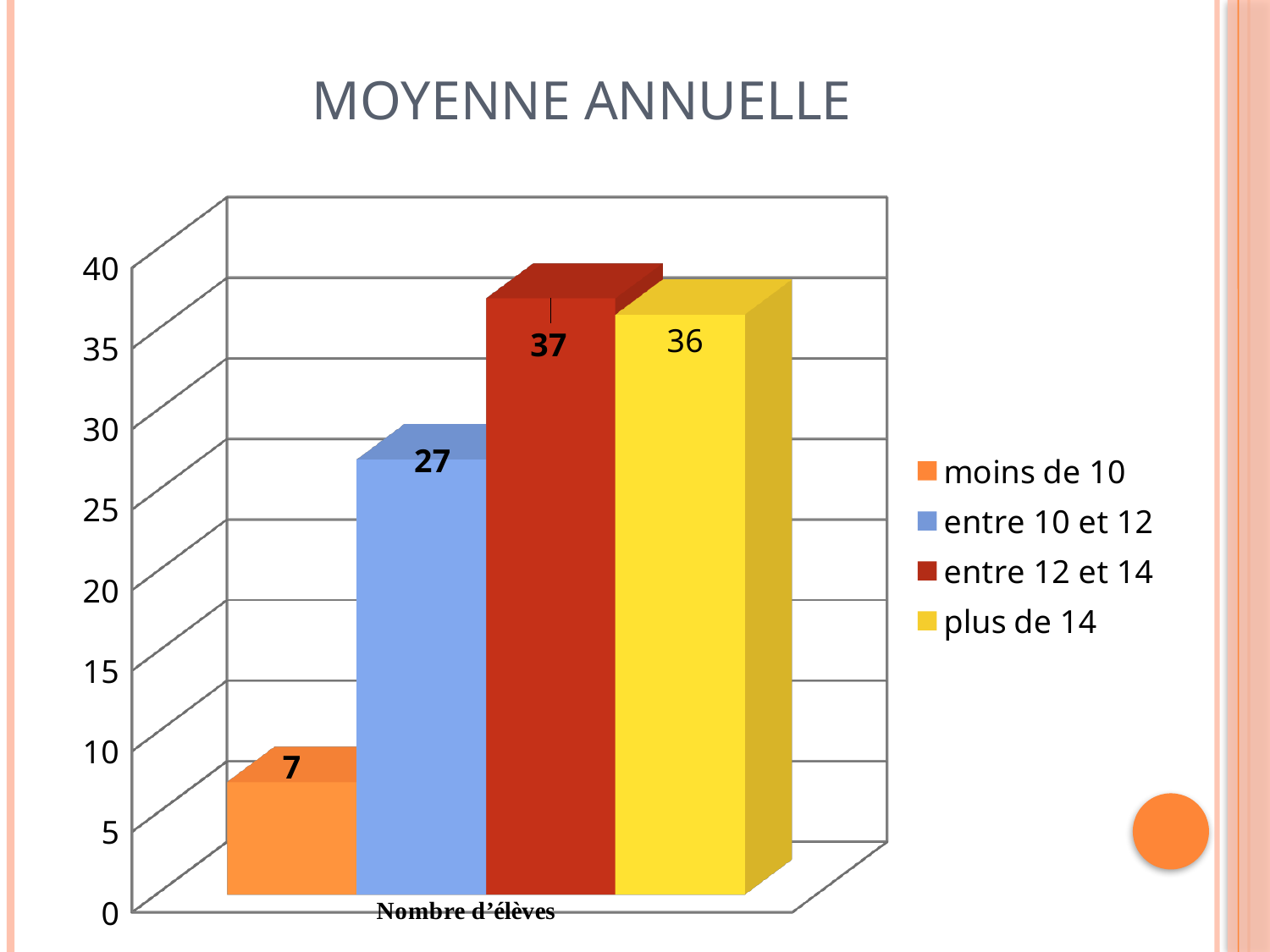
Is the value for "entre 12 et 14" greater or less than 35? greater Which series has the highest value? entre 12 et 14 What kind of chart is shown on the slide? bar chart Which series has the lowest value? moins de 10 What is the title of the chart? MOYENNE ANNUELLE What is the difference between the values for "entre 10 et 12" and "moins de 10"? 20 What is the difference between the values for "entre 12 et 14" and "entre 10 et 12"? 10 How many series does the legend list? 4 What is the value for "entre 10 et 12"? 27 What is the value for "moins de 10"? 7 What is the value for "plus de 14"? 36 Which is larger, the value for "entre 10 et 12" or the value for "plus de 14"? plus de 14